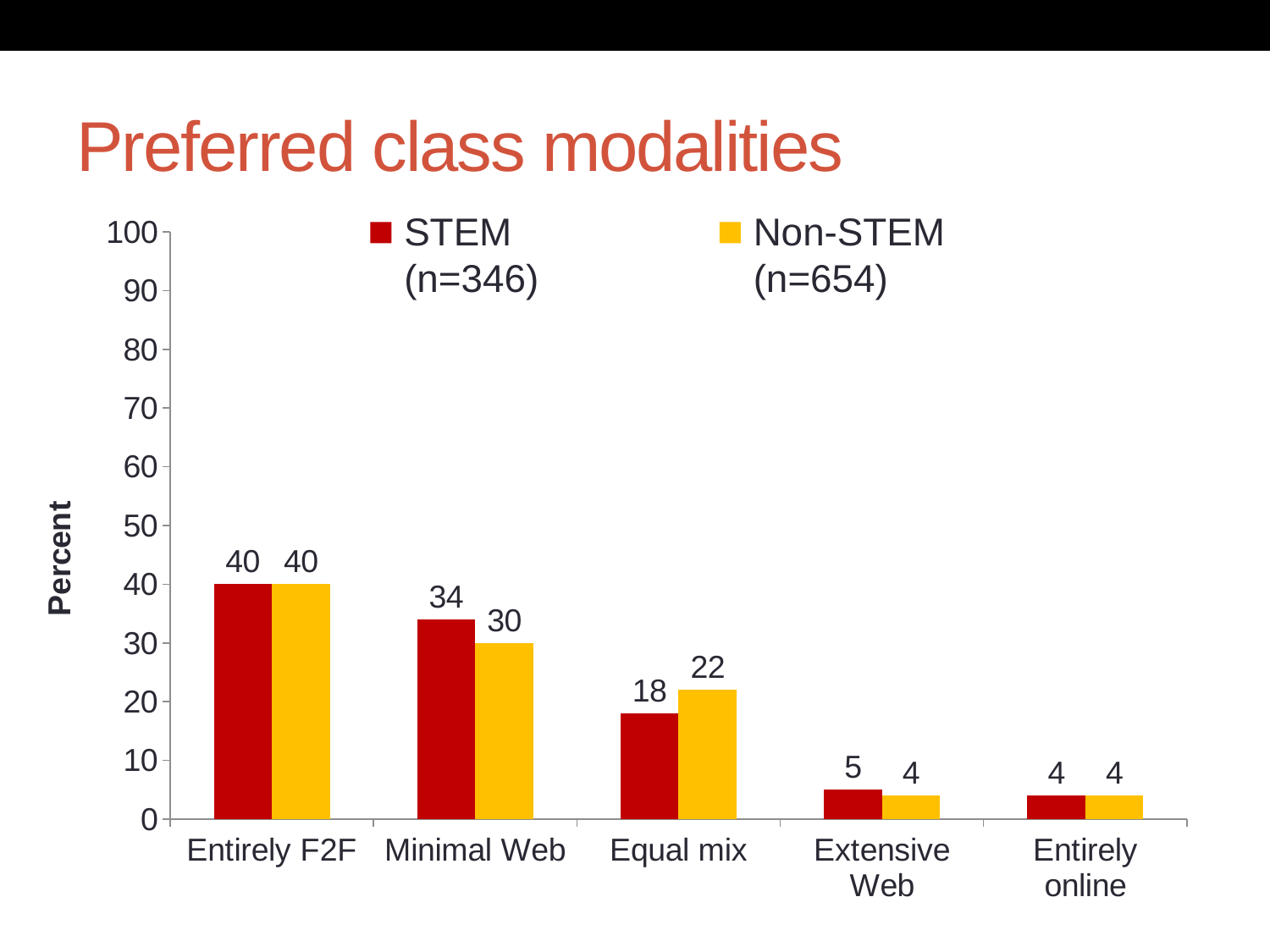
How many series does the legend list? 2 What kind of chart is shown on the slide? Bar chart What is the STEM value for Extensive Web? 5 What is the STEM value for Minimal Web? 34 Which category has the highest Non-STEM value? Entirely F2F Which category has the lowest STEM value? Entirely online For Equal mix, which series has the larger value, STEM or Non-STEM? Non-STEM What is the Non-STEM value for Equal mix? 22 How many categories are shown on the x axis? 5 What is the title of the chart? Preferred class modalities Do the STEM values rise or fall from Entirely F2F to Entirely online? Fall What is the difference between the STEM and Non-STEM values for Minimal Web? 4